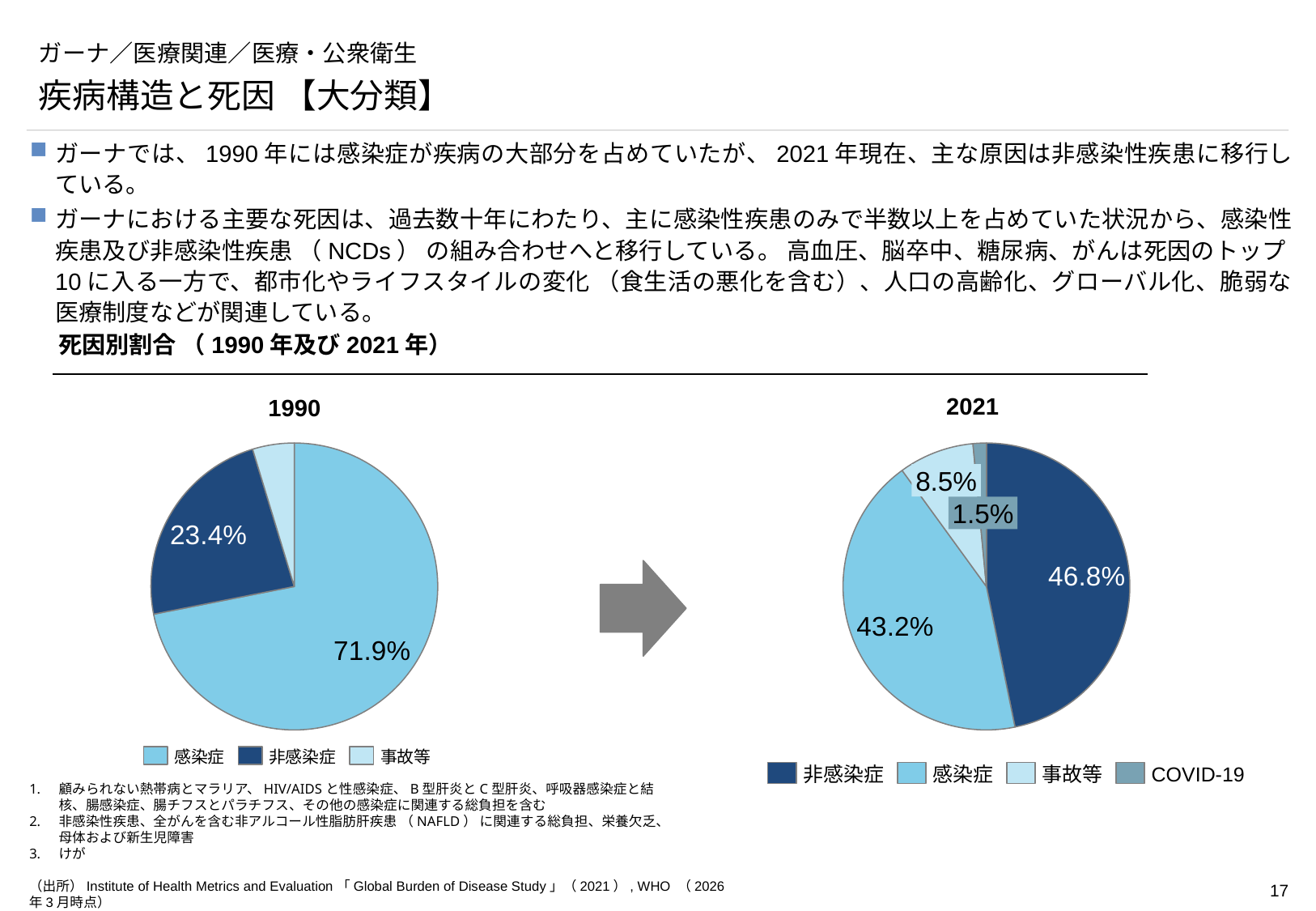
In the 2021 pie chart, what share is shown for COVID-19? 1.5% In the 2021 pie chart, what share is shown for 事故等? 8.5% In the 1990 pie chart, what share is shown for 感染症? 71.9% In the 2021 pie chart, which category has the largest share? 非感染症 In the 2021 pie chart, what share is shown for 非感染症? 46.8% What type of chart is used to show the 1990 data? Pie chart In the 1990 pie chart, what is the difference in percentage points between 感染症 and 非感染症? 48.5 How many categories does the legend of the 2021 pie chart list? 4 In the 2021 pie chart, what is the difference in percentage points between 非感染症 and 感染症? 3.6 In the 1990 pie chart, what share is shown for 非感染症? 23.4% In the 2021 pie chart, which is larger, 感染症 or 事故等? 感染症 In the 1990 pie chart, which category has the smallest share? 事故等